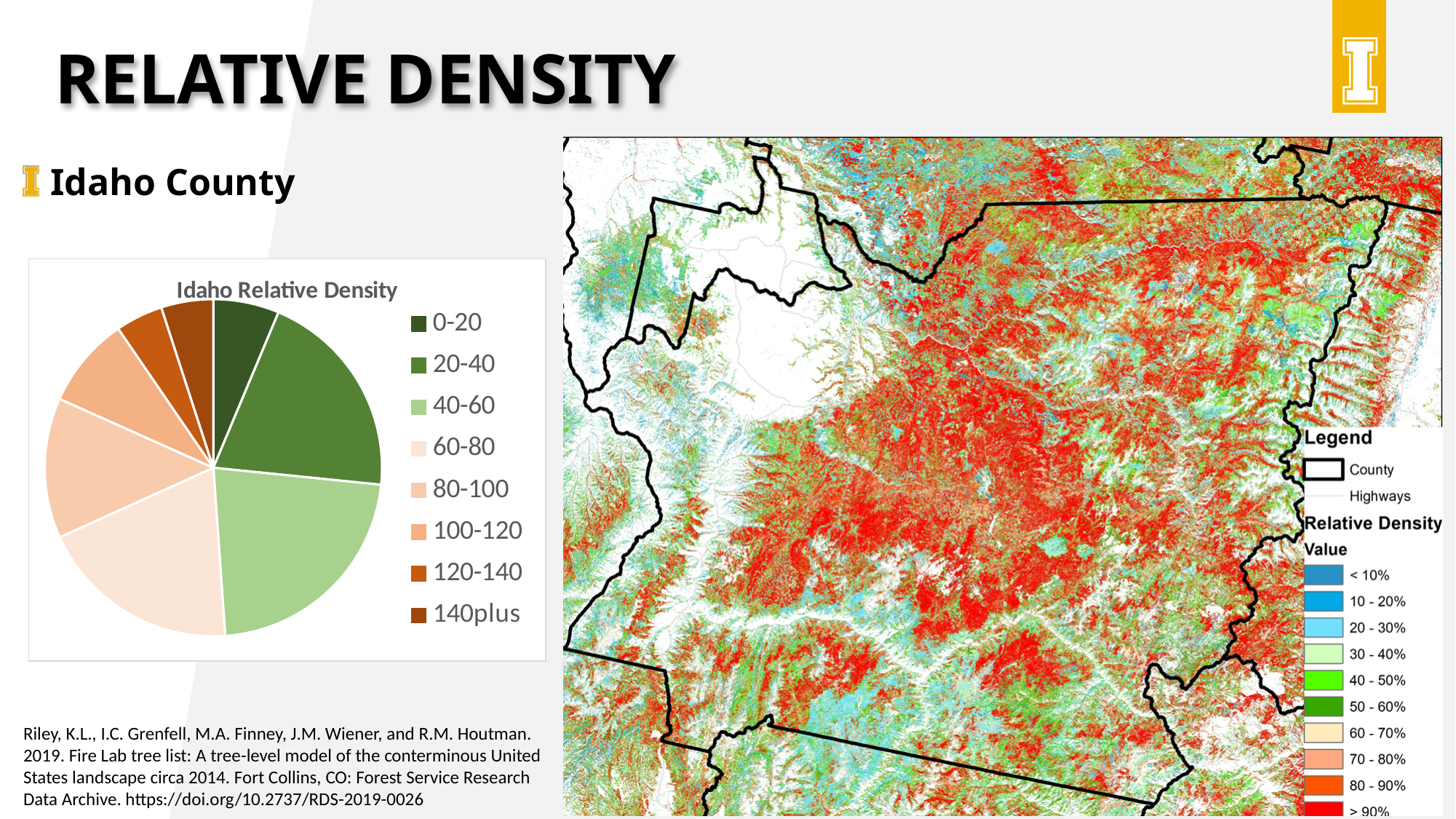
Which category has the largest slice in the "Idaho Relative Density" pie chart? 40-60 In the "Idaho Relative Density" pie chart, which slice is larger, 80-100 or 120-140? 80-100 Which county is the slide about? Idaho County In the "Idaho Relative Density" pie chart, which slice is larger, 40-60 or 0-20? 40-60 In the "Idaho Relative Density" pie chart, which slice is larger, 60-80 or 100-120? 60-80 What is the last legend entry listed for the "Idaho Relative Density" pie chart? 140plus What kind of chart is the "Idaho Relative Density" chart? pie chart What is the title of the pie chart on the slide? Idaho Relative Density How many categories does the "Idaho Relative Density" pie chart have? 8